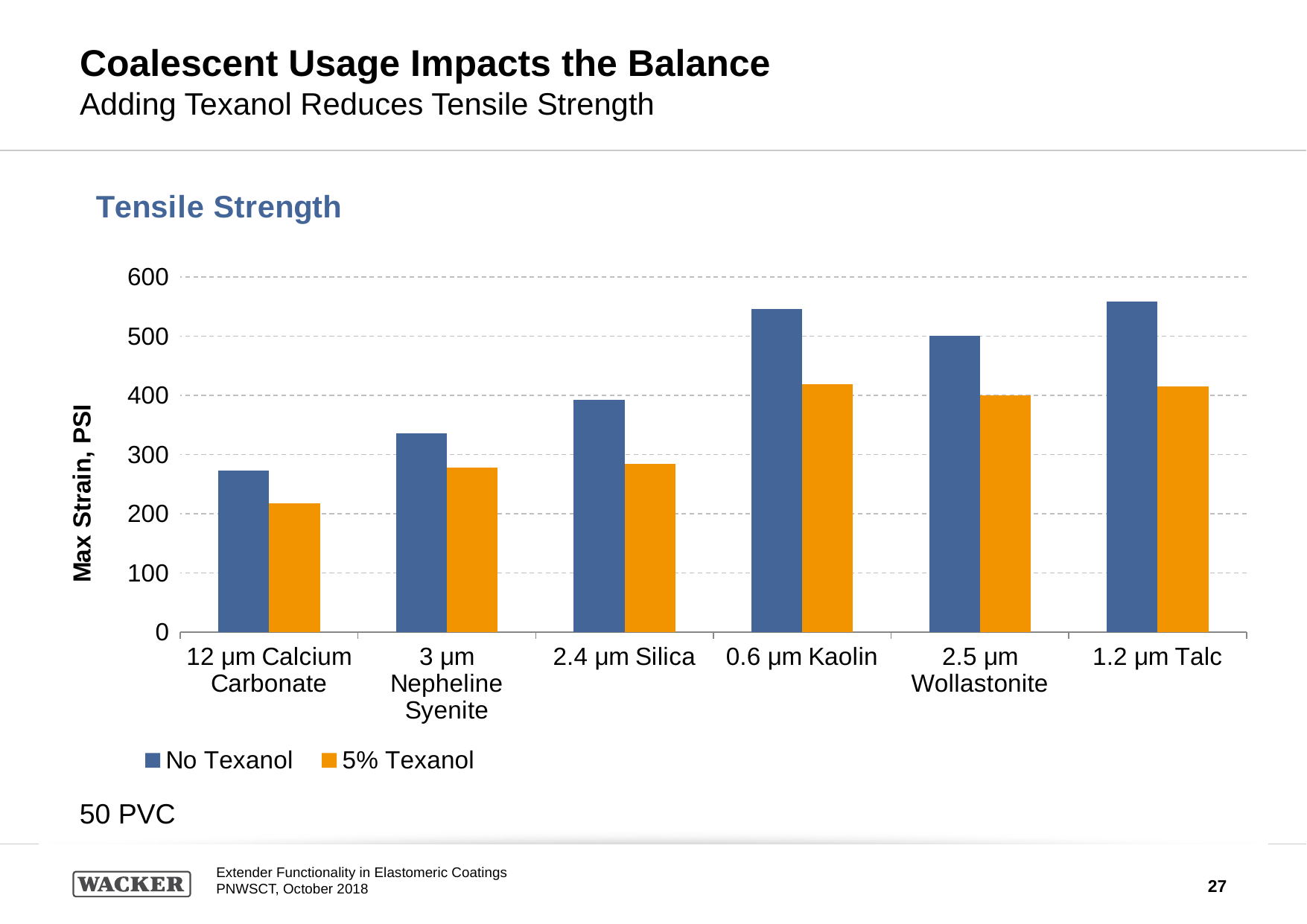
How many series does the legend list? 2 Is the No Texanol value for 2.4 µm Silica greater or less than 400? less Which category has the highest No Texanol value? 1.2 µm Talc Which is larger for 2.5 µm Wollastonite, the No Texanol value or the 5% Texanol value? No Texanol What kind of chart is shown on the slide? bar chart What is the label on the y axis of the chart? Max Strain, PSI Which has the larger No Texanol value, 0.6 µm Kaolin or 2.4 µm Silica? 0.6 µm Kaolin Is the No Texanol value for 0.6 µm Kaolin greater or less than 500? greater Is the 5% Texanol value for 12 µm Calcium Carbonate greater or less than 200? greater Which category has the lowest 5% Texanol value? 12 µm Calcium Carbonate How many extender categories are shown on the x axis? 6 Which category has the lowest No Texanol value? 12 µm Calcium Carbonate